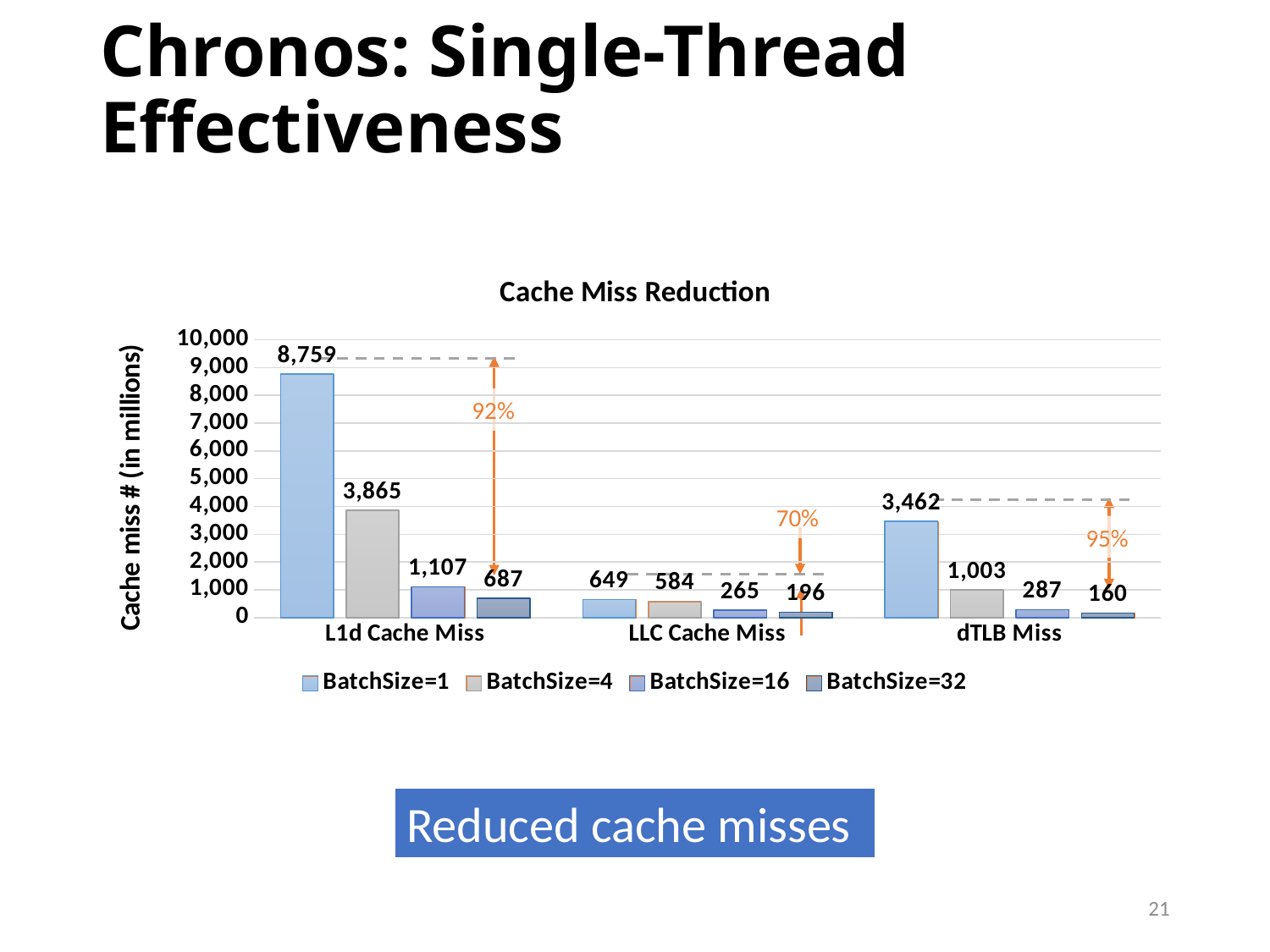
What is the value for BatchSize=16 in the LLC Cache Miss category? 265 How many series does the legend list? 4 How many categories are shown on the x axis? 3 What kind of chart is shown on the slide? Bar chart What is the value for BatchSize=1 in the L1d Cache Miss category? 8,759 What percentage reduction is annotated for the LLC Cache Miss category? 70% What is the difference between the BatchSize=1 and BatchSize=32 values in the L1d Cache Miss category? 8,072 Which is larger: the BatchSize=4 value for L1d Cache Miss or the BatchSize=1 value for dTLB Miss? BatchSize=4 value for L1d Cache Miss Which batch size has the lowest value in the LLC Cache Miss category? BatchSize=32 What is the title of the chart? Cache Miss Reduction What is the value for BatchSize=32 in the dTLB Miss category? 160 Which batch size has the highest value in the dTLB Miss category? BatchSize=1